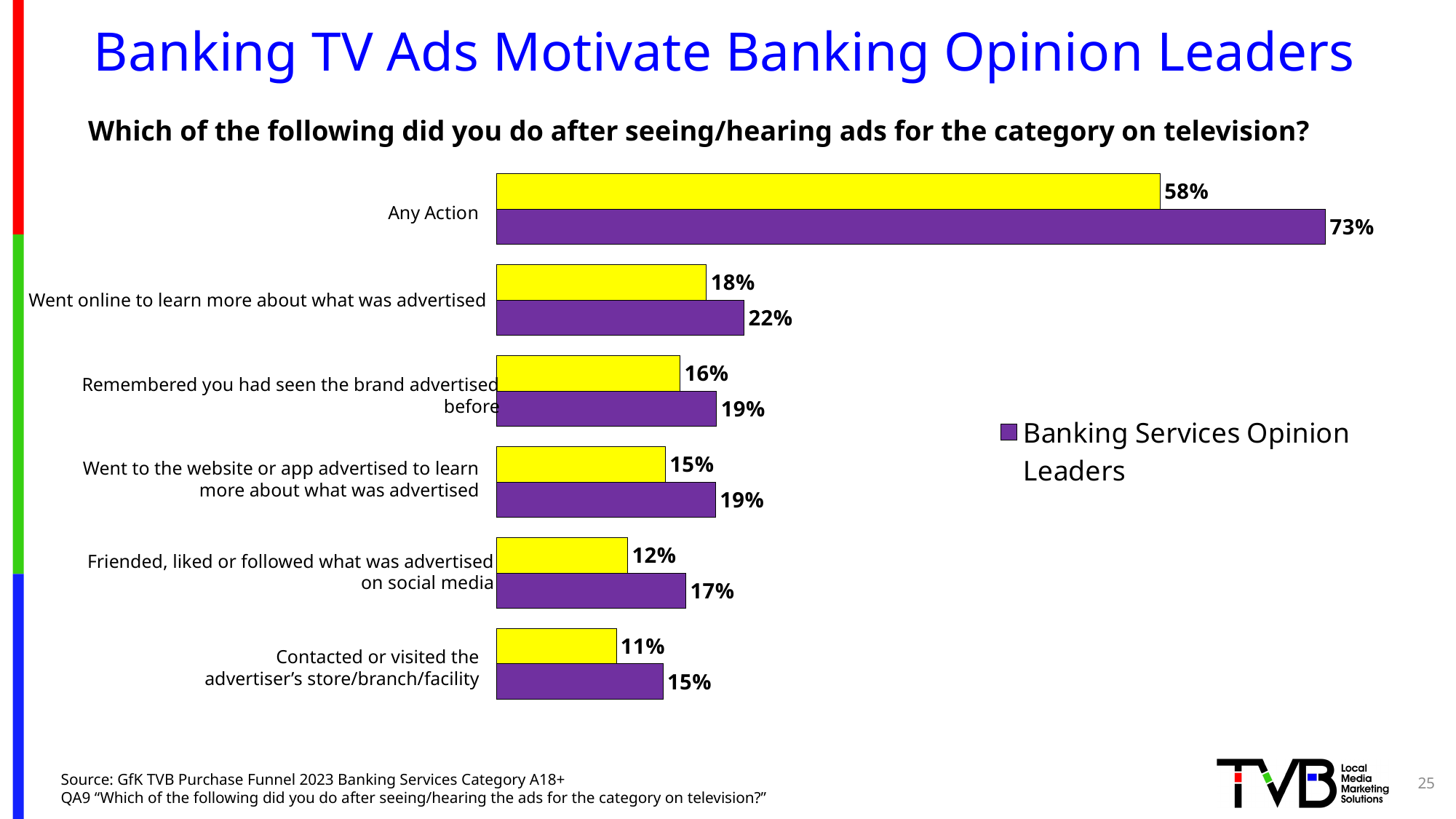
What is the value for Banking Services Opinion Leaders for 'Friended, liked or followed what was advertised on social media'? 17% What is the value of the yellow bar for 'Contacted or visited the advertiser's store/branch/facility'? 11% For 'Remembered you had seen the brand advertised before', which is larger: the purple bar or the yellow bar? the purple bar (19%) Which category has the highest value for Banking Services Opinion Leaders? Any Action What is the value of the purple bar (Banking Services Opinion Leaders) for Any Action? 73% What is the value of the yellow bar for Any Action? 58% What is the value for Banking Services Opinion Leaders for 'Went online to learn more about what was advertised'? 22% Which category has the lowest value for the yellow bars? Contacted or visited the advertiser's store/branch/facility What kind of chart is shown on the slide? bar chart How many categories are shown on the chart? 6 How many series does the legend list? 1 What is the difference between the Banking Services Opinion Leaders value and the yellow bar value for Any Action? 15 percentage points